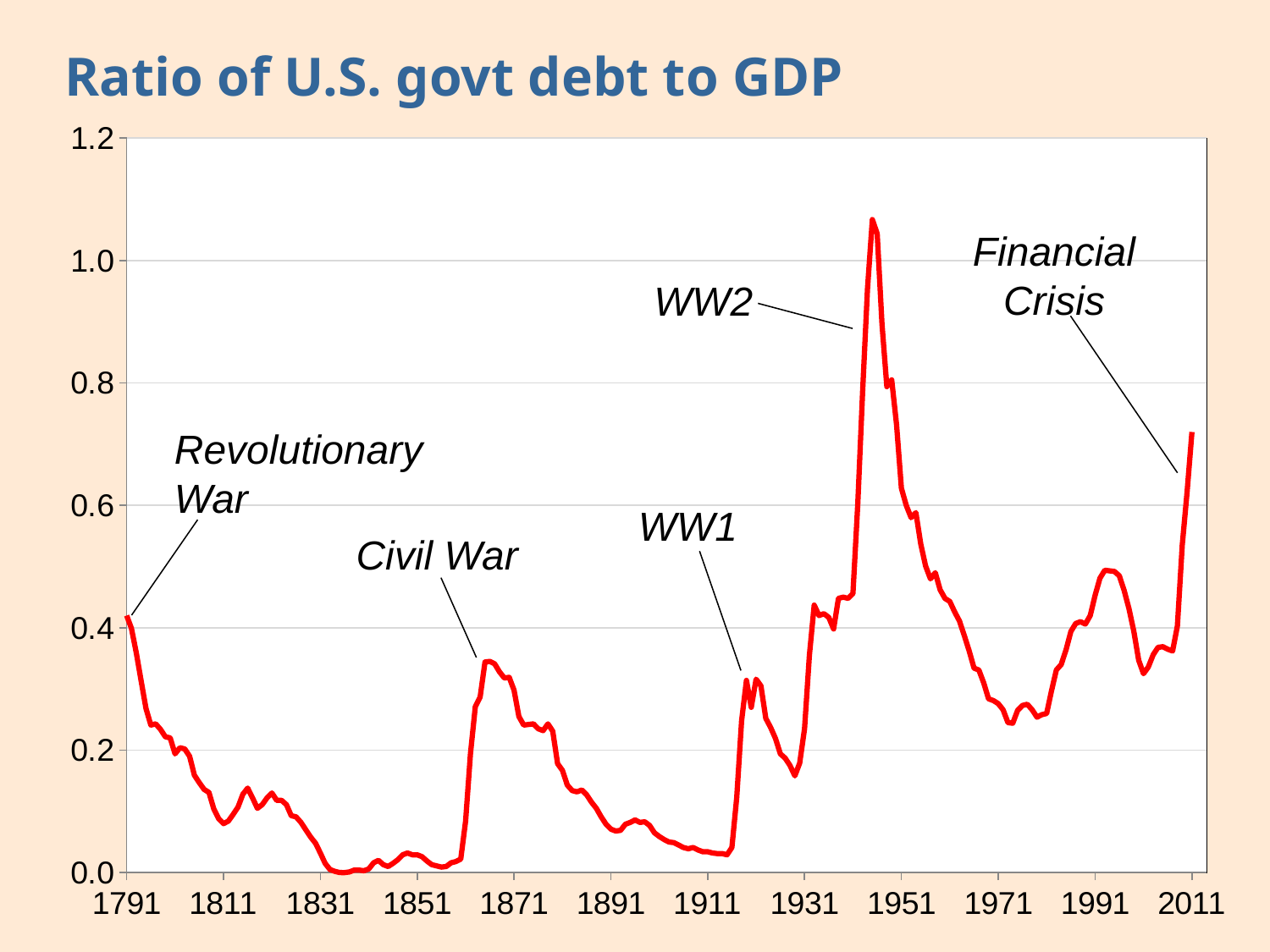
Which is larger, the peak of the ratio at the Civil War or the peak at WW2? WW2 How many historical events are annotated on the chart? 5 Does the ratio rise or fall between 1791 and 1831? fall Does the ratio rise or fall from its WW2 peak to 1971? fall Is the value of the ratio around 1831 greater or less than 0.2? less Is the value of the ratio at the end of the series (2011, Financial Crisis) greater or less than 0.6? greater Is the peak value of the ratio at WW2 greater or less than 1.0? greater Which is larger, the value of the ratio at the Financial Crisis (2011) or the peak at WW1? Financial Crisis Which annotated event corresponds to the highest peak of the debt-to-GDP ratio? WW2 What kind of chart is shown on the slide? line chart What is the title of the chart? Ratio of U.S. govt debt to GDP